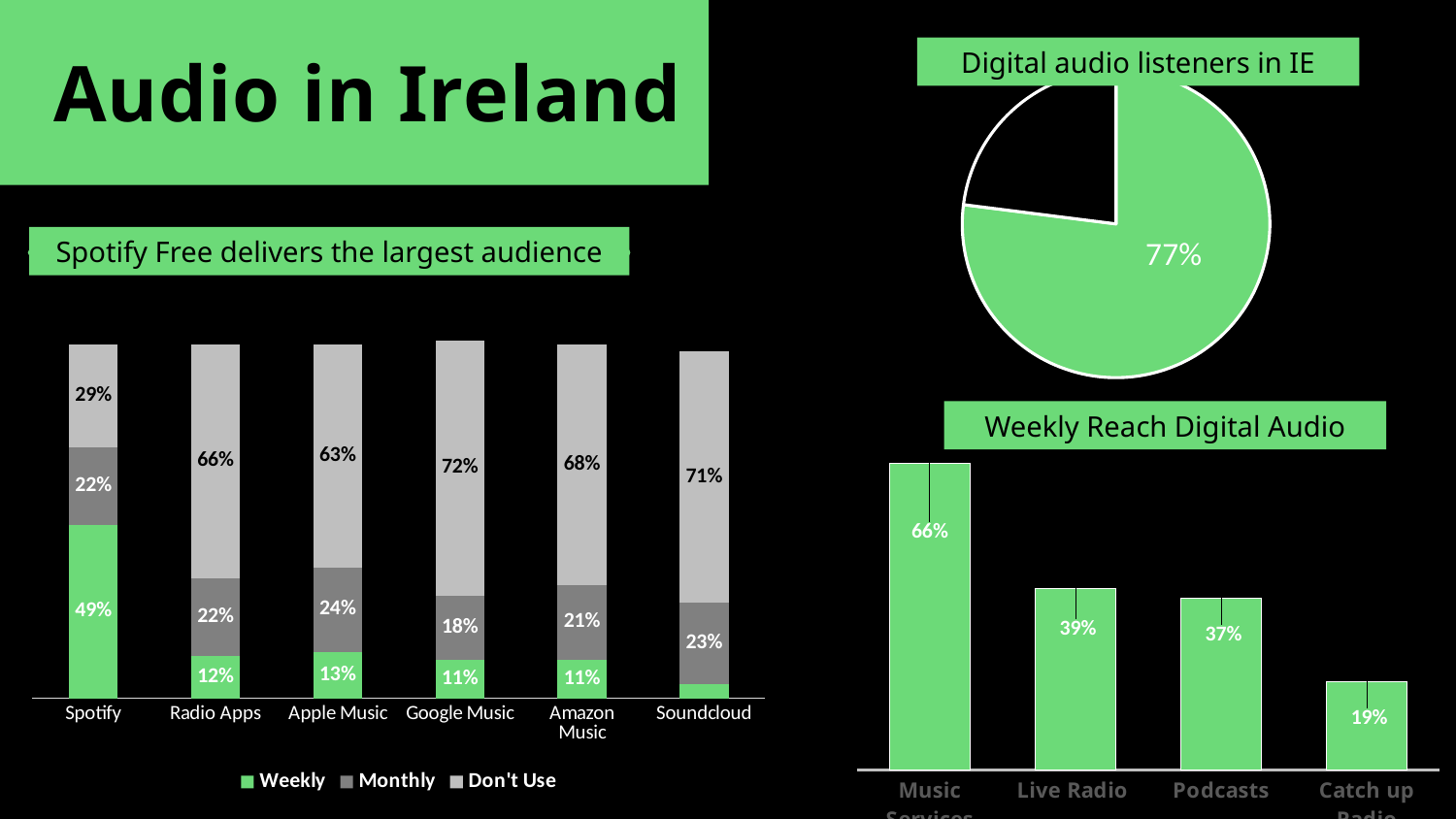
In the 'Spotify Free delivers the largest audience' chart, which category has the highest Weekly value? Spotify In the 'Spotify Free delivers the largest audience' chart, how many series does the legend list? 3 In the 'Spotify Free delivers the largest audience' chart, what is the Don't Use value for Google Music? 72% In the 'Weekly Reach Digital Audio' chart, what is the difference between Music Services and Live Radio? 27% What kind of chart is 'Digital audio listeners in IE'? Pie chart In the 'Spotify Free delivers the largest audience' chart, which is larger: the Monthly value for Apple Music or the Monthly value for Google Music? Apple Music In the 'Spotify Free delivers the largest audience' chart, what is the difference between the Don't Use values for Google Music and Apple Music? 9% In the 'Spotify Free delivers the largest audience' chart, how many categories are shown on the x axis? 6 In the 'Weekly Reach Digital Audio' chart, what is the value for Podcasts? 37% In the 'Weekly Reach Digital Audio' chart, which category has the lowest value? Catch up Radio In the 'Spotify Free delivers the largest audience' chart, what is the Weekly value for Spotify? 49% In the 'Digital audio listeners in IE' chart, what share is shown for the green slice? 77%